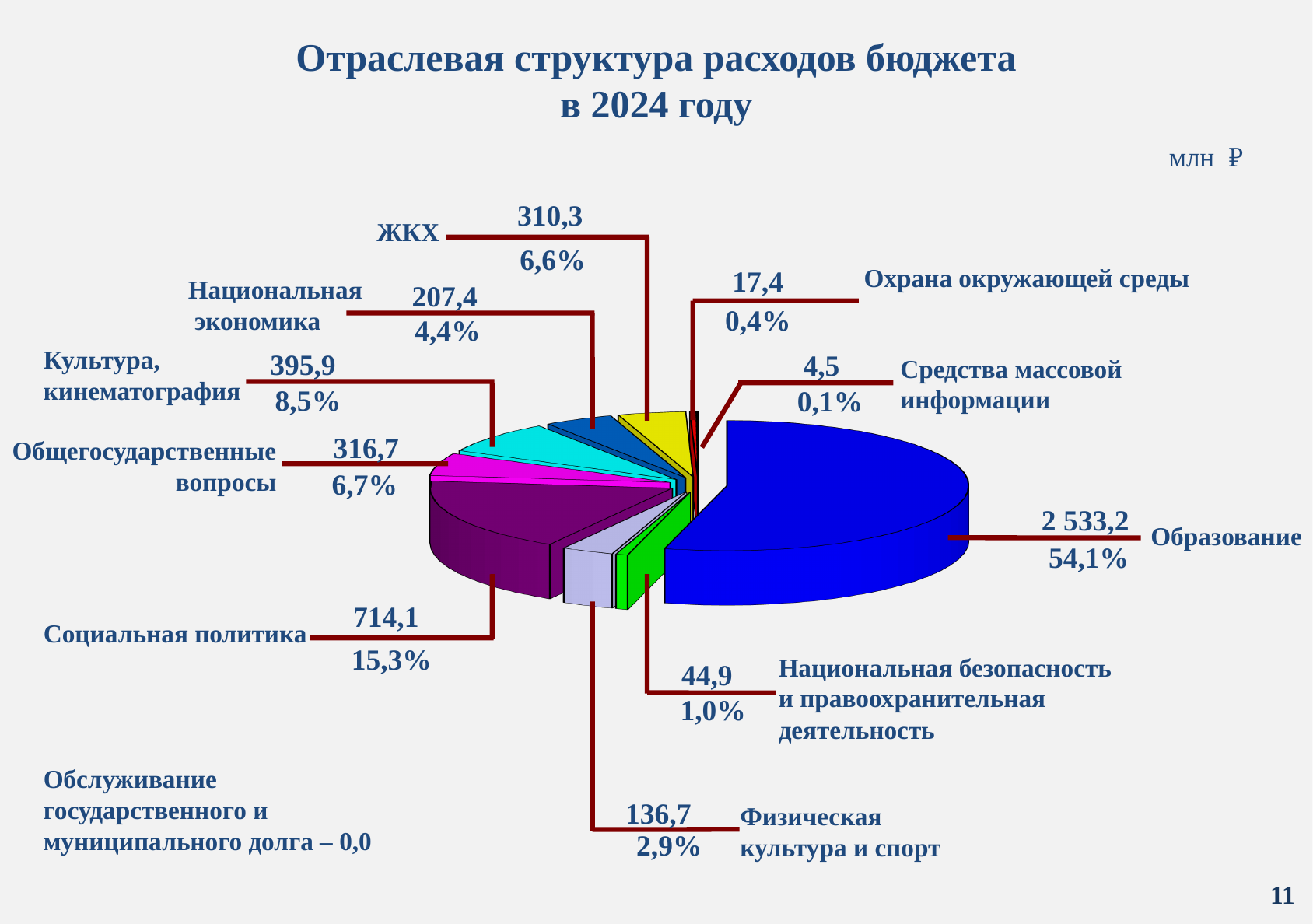
What kind of chart is shown on the slide? Pie chart What is the value for Социальная политика? 714,1 What is the value for Образование? 2 533,2 What share of the pie does Образование take? 54,1% What is the value for Физическая культура и спорт? 136,7 Which category has the smallest non-zero value? Средства массовой информации What is the value for Обслуживание государственного и муниципального долга? 0,0 What share of the pie does Социальная политика take? 15,3% In what units are the values on the chart given? млн ₽ Which category has the largest value? Образование What is the difference between the values for Культура, кинематография and Общегосударственные вопросы? 79,2 Which is larger, the value for ЖКХ or the value for Общегосударственные вопросы? Общегосударственные вопросы